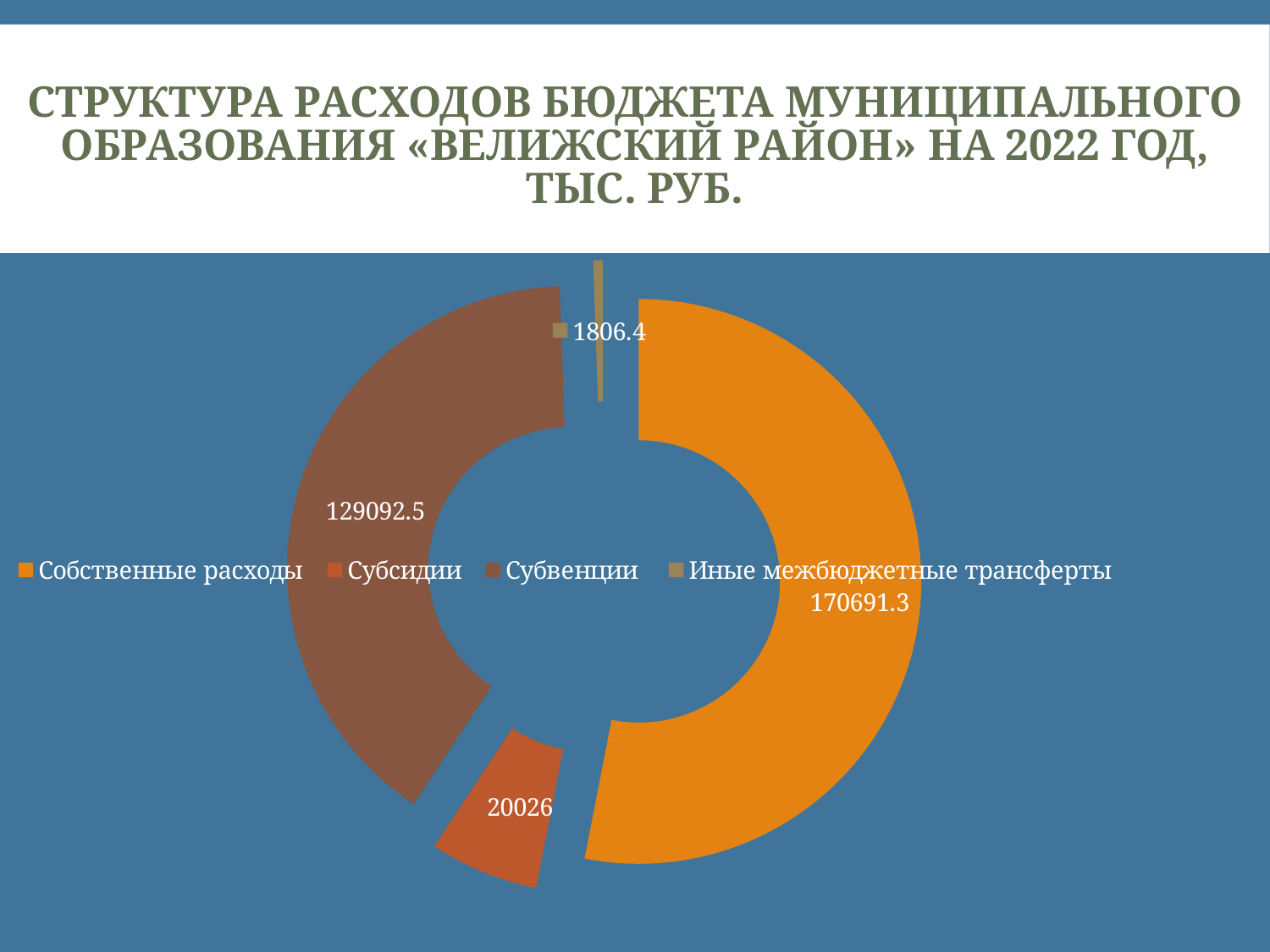
Which category has the highest value? Собственные расходы What is the value for Собственные расходы? 170691.3 Which is larger, Субсидии or Субвенции? Субвенции How many categories does the chart show? 4 What is the difference between Собственные расходы and Субвенции? 41598.8 What is the difference between Субсидии and Иные межбюджетные трансферты? 18219.6 What colour is the Собственные расходы segment? orange What is the value for Субвенции? 129092.5 What is the value for Иные межбюджетные трансферты? 1806.4 Which category has the lowest value? Иные межбюджетные трансферты What kind of chart is shown on the slide? doughnut chart What is the value for Субсидии? 20026